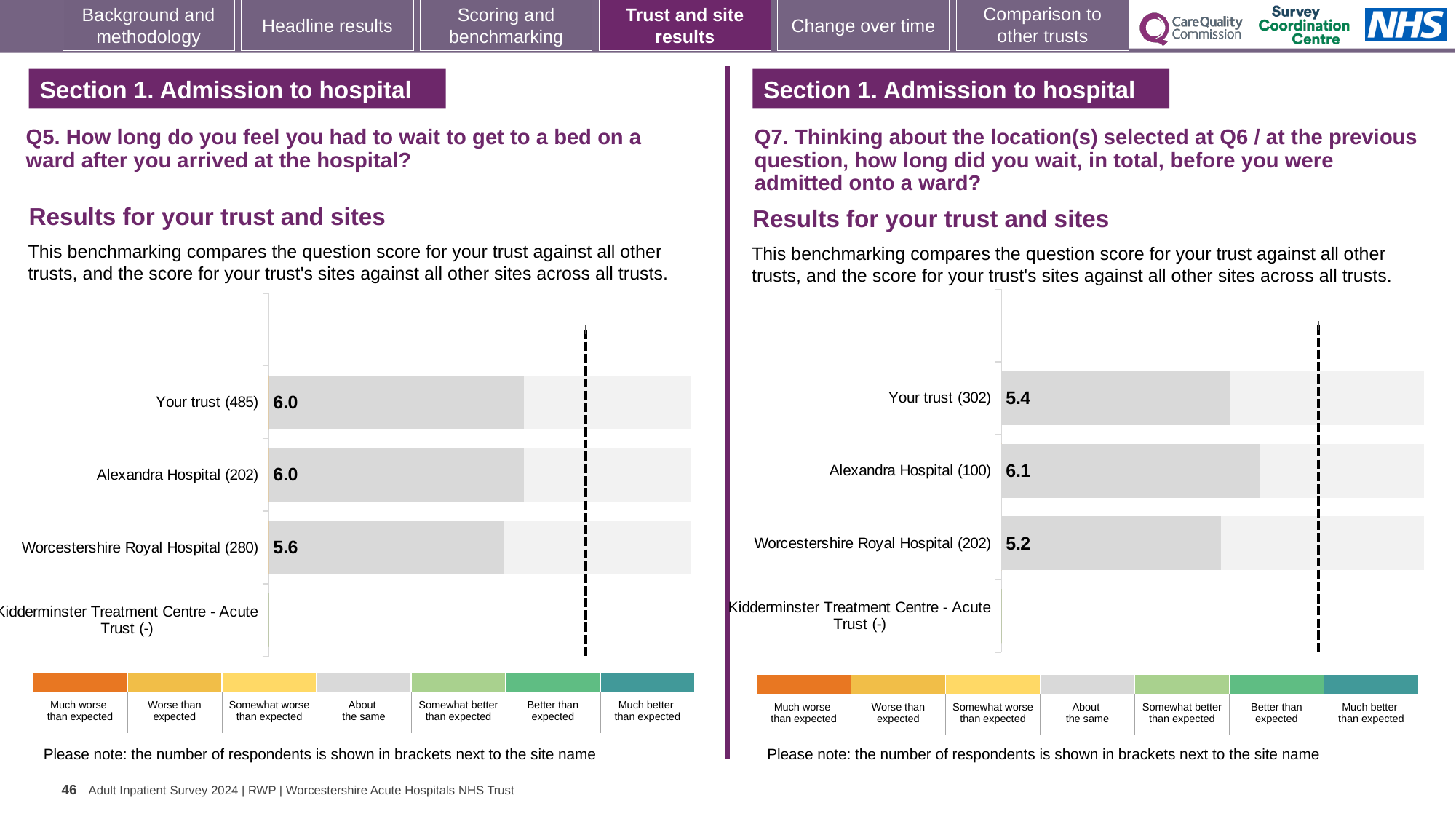
In the Q7 chart on the right, which is larger: the score for Your trust or the score for Alexandra Hospital? Alexandra Hospital In the Q7 chart on the right, what is the difference between the scores for Alexandra Hospital and Worcestershire Royal Hospital? 0.9 In the Q5 chart on the left, which has the lowest score among the bars shown? Worcestershire Royal Hospital In the Q5 chart on the left, how many respondents are shown in brackets for Your trust? 485 In the Q5 chart on the left, what is the score for Your trust? 6.0 In the Q7 chart on the right, what is the score for Alexandra Hospital? 6.1 In the Q5 chart on the left, what is the score for Worcestershire Royal Hospital? 5.6 In the Q5 chart on the left, what is the difference between the scores for Your trust and Worcestershire Royal Hospital? 0.4 What type of chart is used on the left for Q5? Bar chart In the Q7 chart on the right, which site or trust has the highest score? Alexandra Hospital In the Q7 chart on the right, what is the score for Worcestershire Royal Hospital? 5.2 In the Q7 chart on the right, which site or trust has the lowest score? Worcestershire Royal Hospital